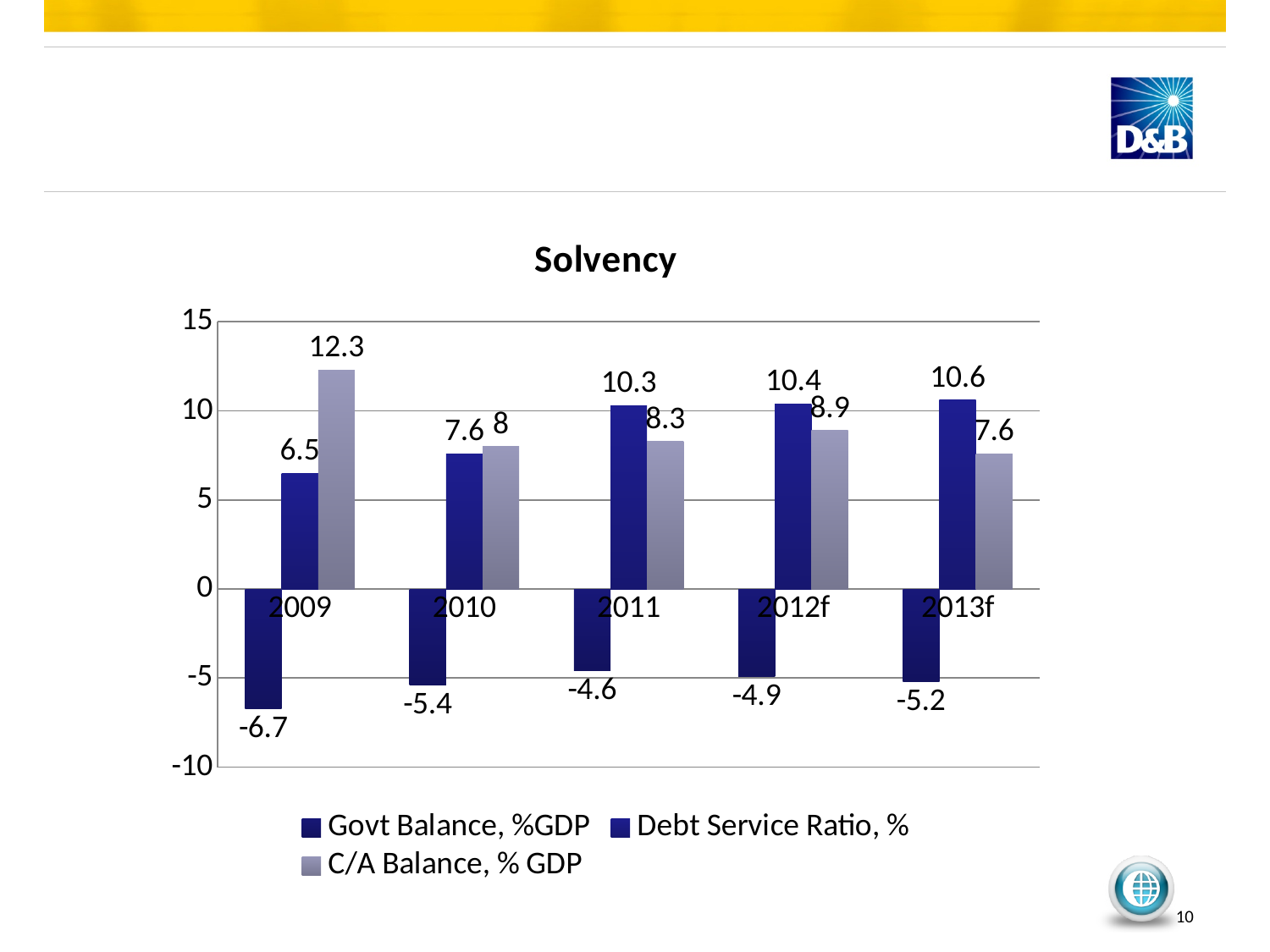
What is the Debt Service Ratio, % value for 2013f? 10.6 What is the C/A Balance, % GDP value for 2010? 8 How many years are shown on the x axis? 5 In which year is the C/A Balance, % GDP highest? 2009 In which year is the Debt Service Ratio, % lowest? 2009 What is the Govt Balance, %GDP value for 2009? -6.7 What is the difference between the C/A Balance, % GDP in 2009 and in 2013f? 4.7 What type of chart is shown on the slide? bar chart Does the Debt Service Ratio, % rise or fall from 2009 to 2013f? rise How many series does the legend list? 3 Which is larger in 2012f, the Debt Service Ratio, % or the C/A Balance, % GDP? Debt Service Ratio, % What is the title of the chart? Solvency